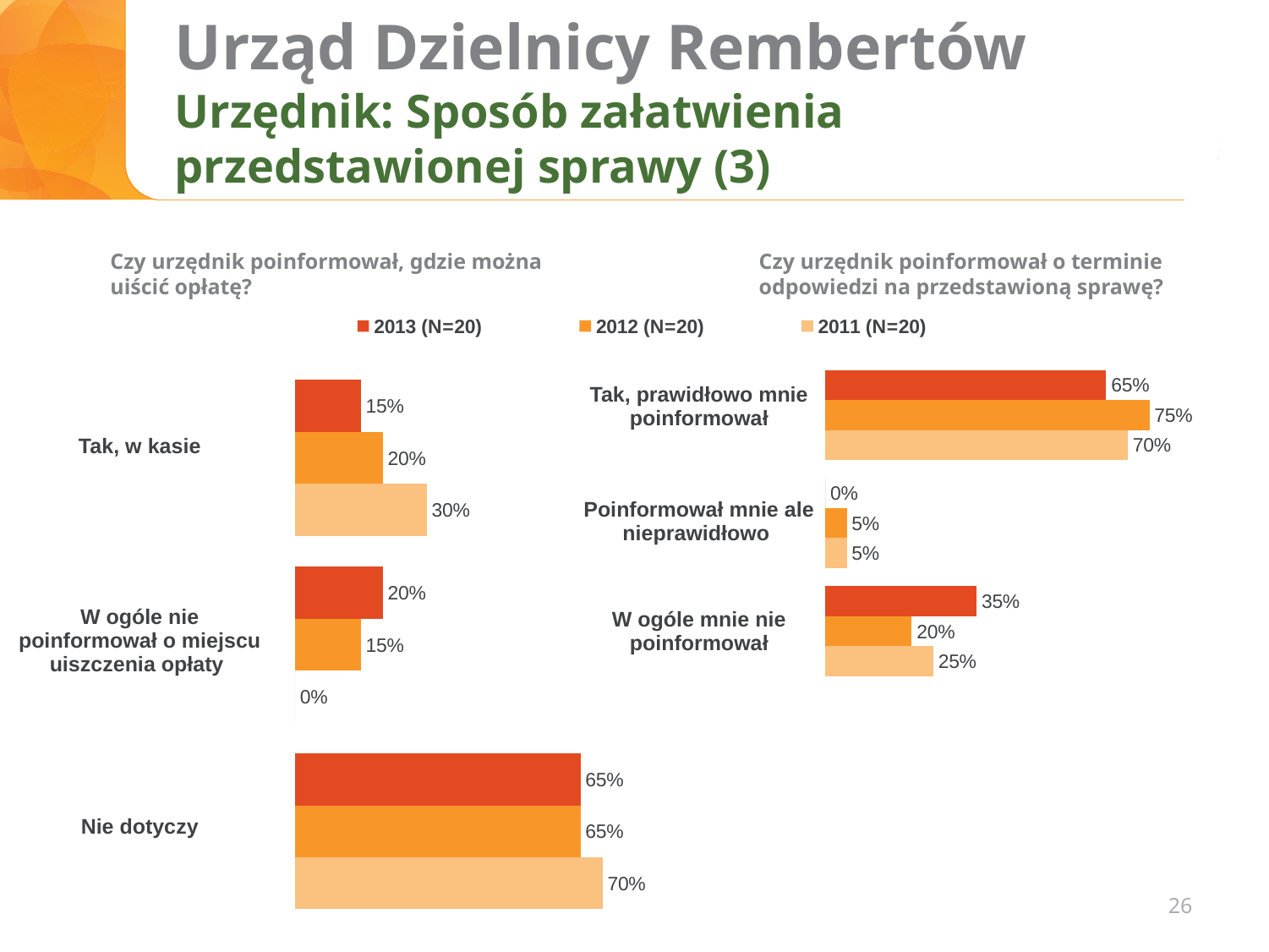
In the left chart ("Czy urzędnik poinformował, gdzie można uiścić opłatę?"), what is the value for "Nie dotyczy" in 2013? 65% What type of chart is the right chart ("Czy urzędnik poinformował o terminie odpowiedzi na przedstawioną sprawę?")? Bar chart In the left chart ("Czy urzędnik poinformował, gdzie można uiścić opłatę?"), which category has the lowest value for 2011? W ogóle nie poinformował o miejscu uiszczenia opłaty In the right chart ("Czy urzędnik poinformował o terminie odpowiedzi na przedstawioną sprawę?"), which is larger for "Tak, prawidłowo mnie poinformował": the 2013 value or the 2011 value? 2011 In the right chart ("Czy urzędnik poinformował o terminie odpowiedzi na przedstawioną sprawę?"), what is the value for "W ogóle mnie nie poinformował" in 2013? 35% How many categories does the left chart ("Czy urzędnik poinformował, gdzie można uiścić opłatę?") show? 3 In the left chart ("Czy urzędnik poinformował, gdzie można uiścić opłatę?"), what is the value for "Tak, w kasie" in 2011? 30% In the right chart ("Czy urzędnik poinformował o terminie odpowiedzi na przedstawioną sprawę?"), what is the difference between the 2013 and 2012 values for "W ogóle mnie nie poinformował"? 15% In the right chart ("Czy urzędnik poinformował o terminie odpowiedzi na przedstawioną sprawę?"), what is the value for "Tak, prawidłowo mnie poinformował" in 2012? 75% How many series does the legend list? 3 In the right chart ("Czy urzędnik poinformował o terminie odpowiedzi na przedstawioną sprawę?"), which category has the highest value for 2012? Tak, prawidłowo mnie poinformował In the left chart ("Czy urzędnik poinformował, gdzie można uiścić opłatę?"), what is the difference between the 2011 and 2013 values for "Tak, w kasie"? 15%